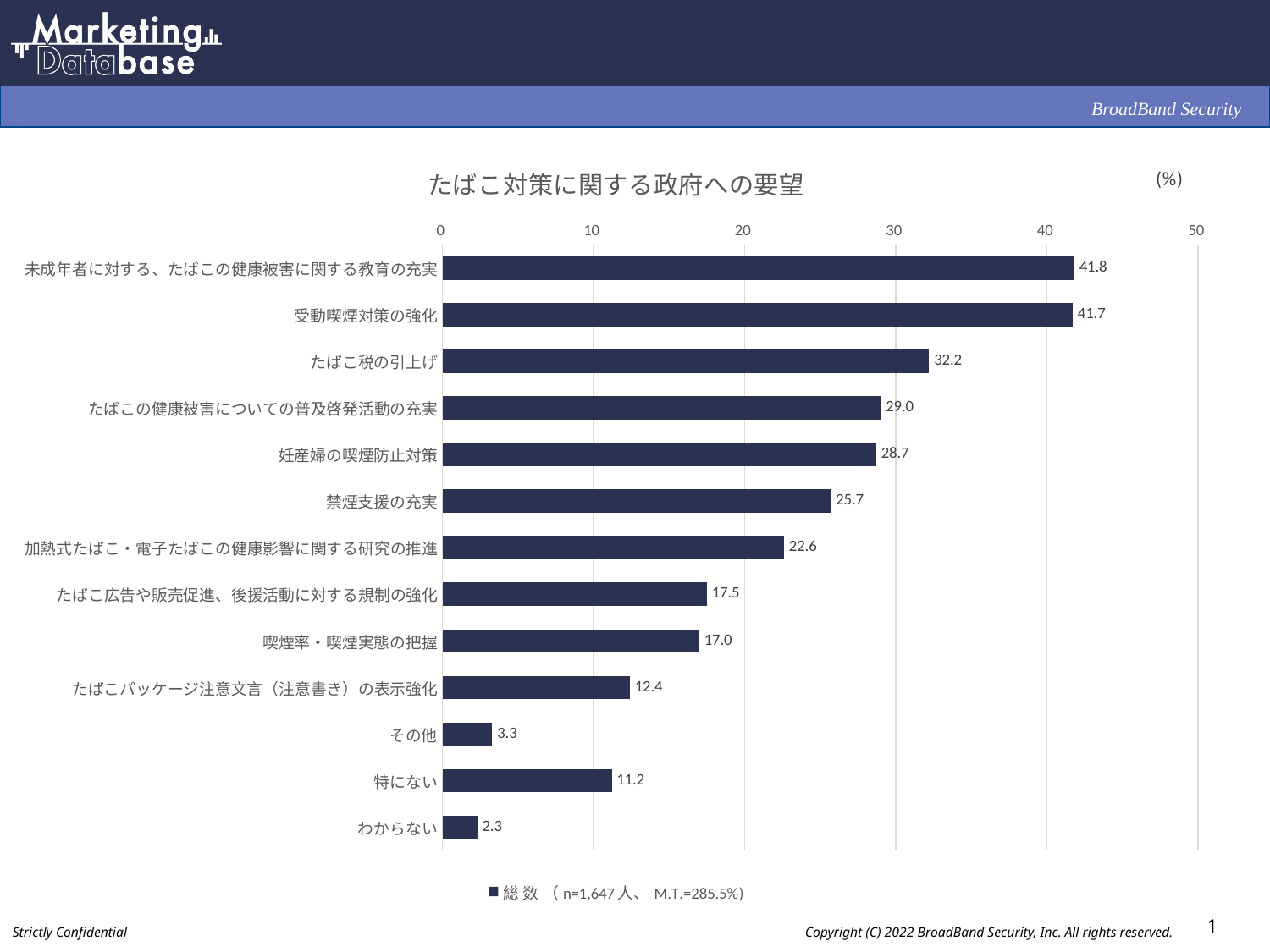
What kind of chart is shown on the slide? bar chart What is the value for 受動喫煙対策の強化? 41.7 What is the value for 特にない? 11.2 What is the value for 禁煙支援の充実? 25.7 Which category has the lowest value? わからない What is the difference between the values for たばこ税の引上げ and たばこの健康被害についての普及啓発活動の充実? 3.2 What is the value for たばこ税の引上げ? 32.2 How many categories are shown in the chart? 13 Is the value for 加熱式たばこ・電子たばこの健康影響に関する研究の推進 greater or less than 20? greater Which is larger, the value for その他 or the value for 特にない? 特にない Which category has the highest value? 未成年者に対する、たばこの健康被害に関する教育の充実 What is the title of the chart? たばこ対策に関する政府への要望